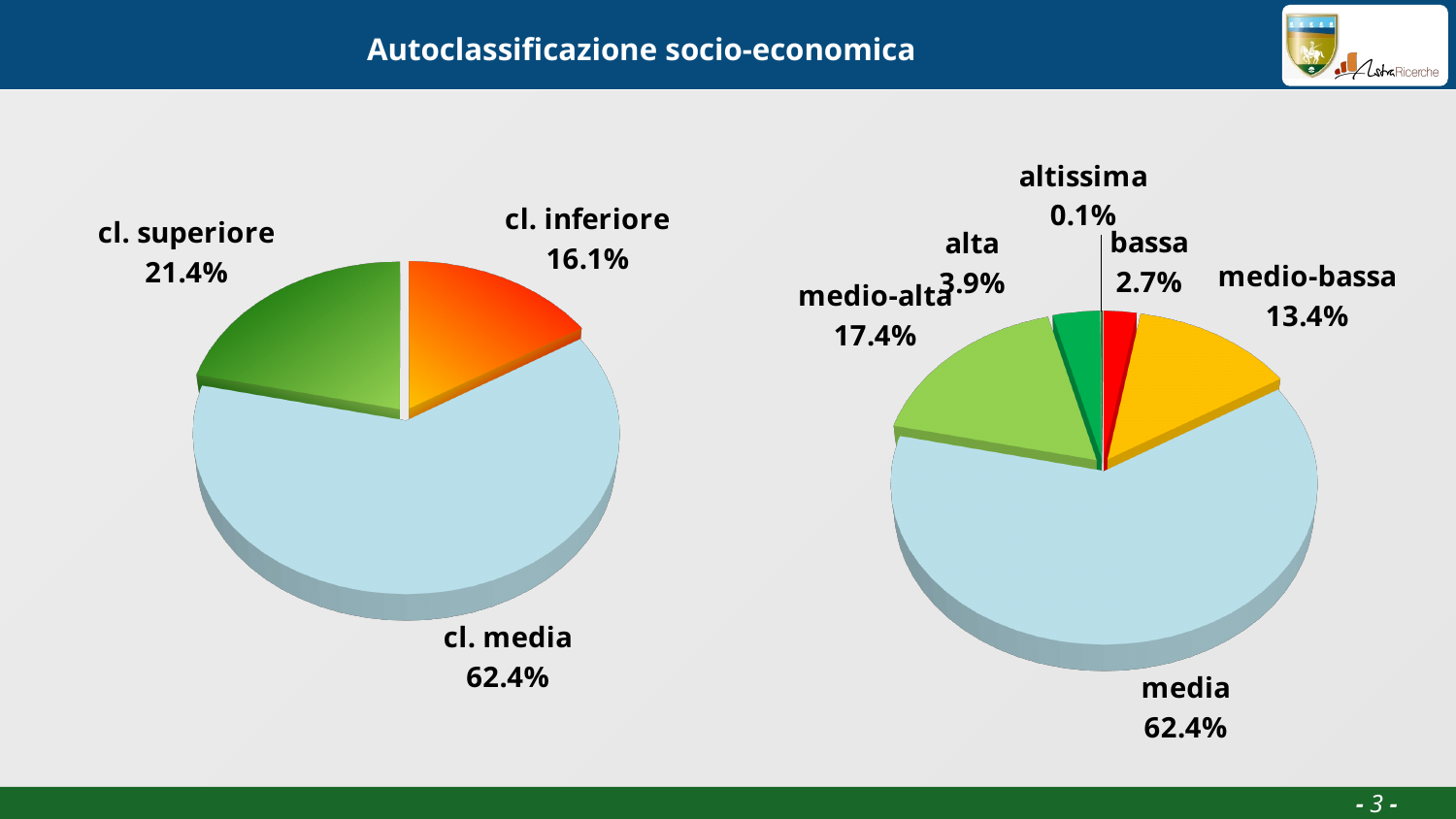
In the left pie chart, what is the difference between cl. superiore and cl. inferiore? 5.3% In the left pie chart, which category has the lowest value? cl. inferiore In the right pie chart, which category has the highest value? media In the right pie chart, what is the value for medio-bassa? 13.4% What kind of chart is the chart on the left? pie chart In the left pie chart, what is the value for cl. media? 62.4% In the right pie chart, which is larger, alta or bassa? alta In the left pie chart, how many categories are shown? 3 In the right pie chart, how many categories are shown? 6 In the right pie chart, what is the difference between medio-alta and medio-bassa? 4.0% In the left pie chart, what is the value for cl. superiore? 21.4% In the right pie chart, what is the value for altissima? 0.1%